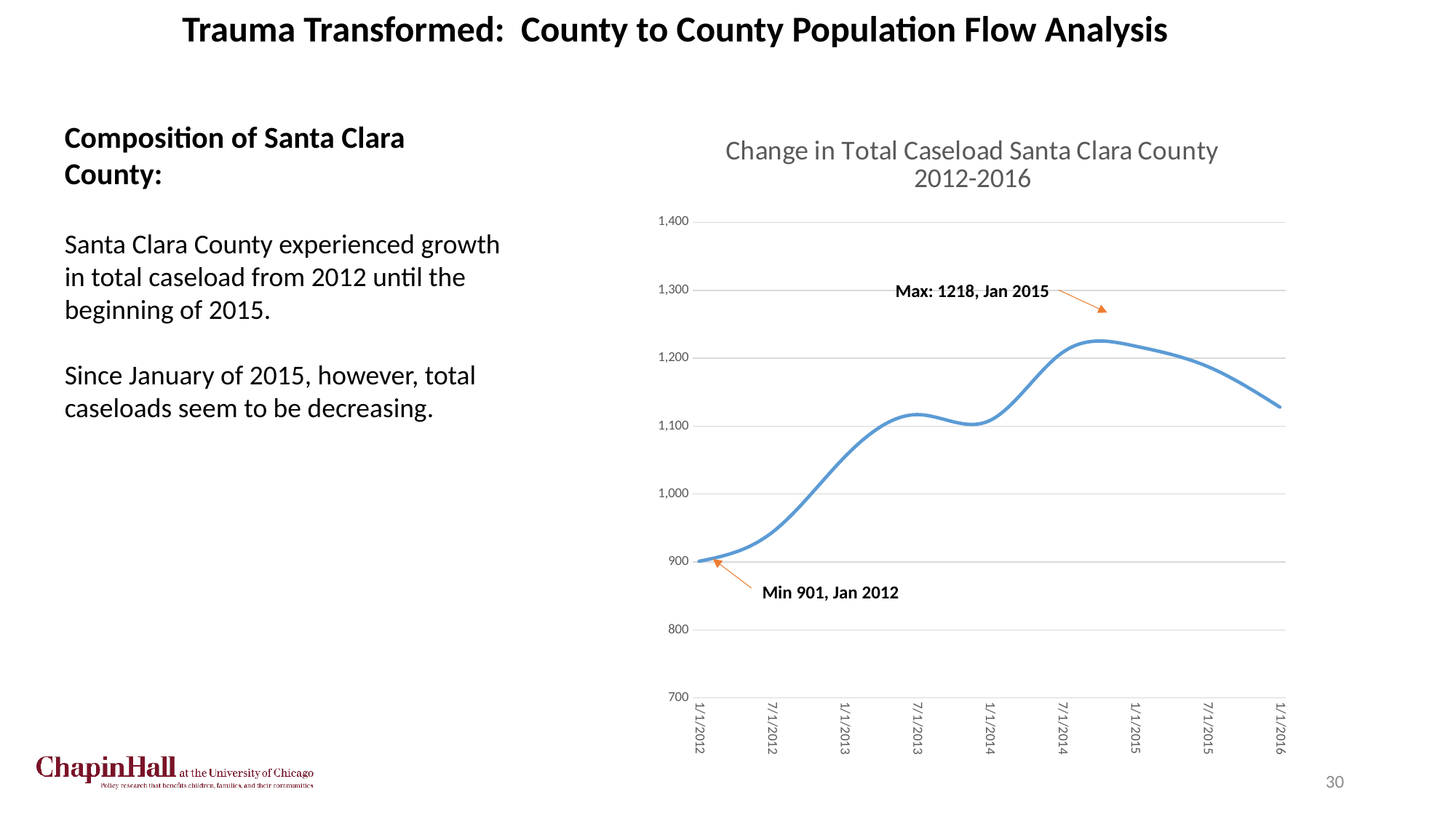
How many date labels are shown on the x axis? 9 In which month does the chart label the minimum caseload? Jan 2012 What is the difference between the labelled maximum (1218) and minimum (901) caseload values? 317 What is the title of the chart? Change in Total Caseload Santa Clara County 2012-2016 What kind of chart is shown on the slide? line chart What is the minimum total caseload value labelled on the chart? 901 Does the total caseload rise or fall between 1/1/2015 and 1/1/2016? fall In which month does the chart label the maximum caseload? Jan 2015 Is the value for 1/1/2013 greater or less than 1,000? greater Does the total caseload rise or fall between 1/1/2012 and 1/1/2015? rise Is the value for 1/1/2016 greater or less than 1,100? greater What is the maximum total caseload value labelled on the chart? 1218